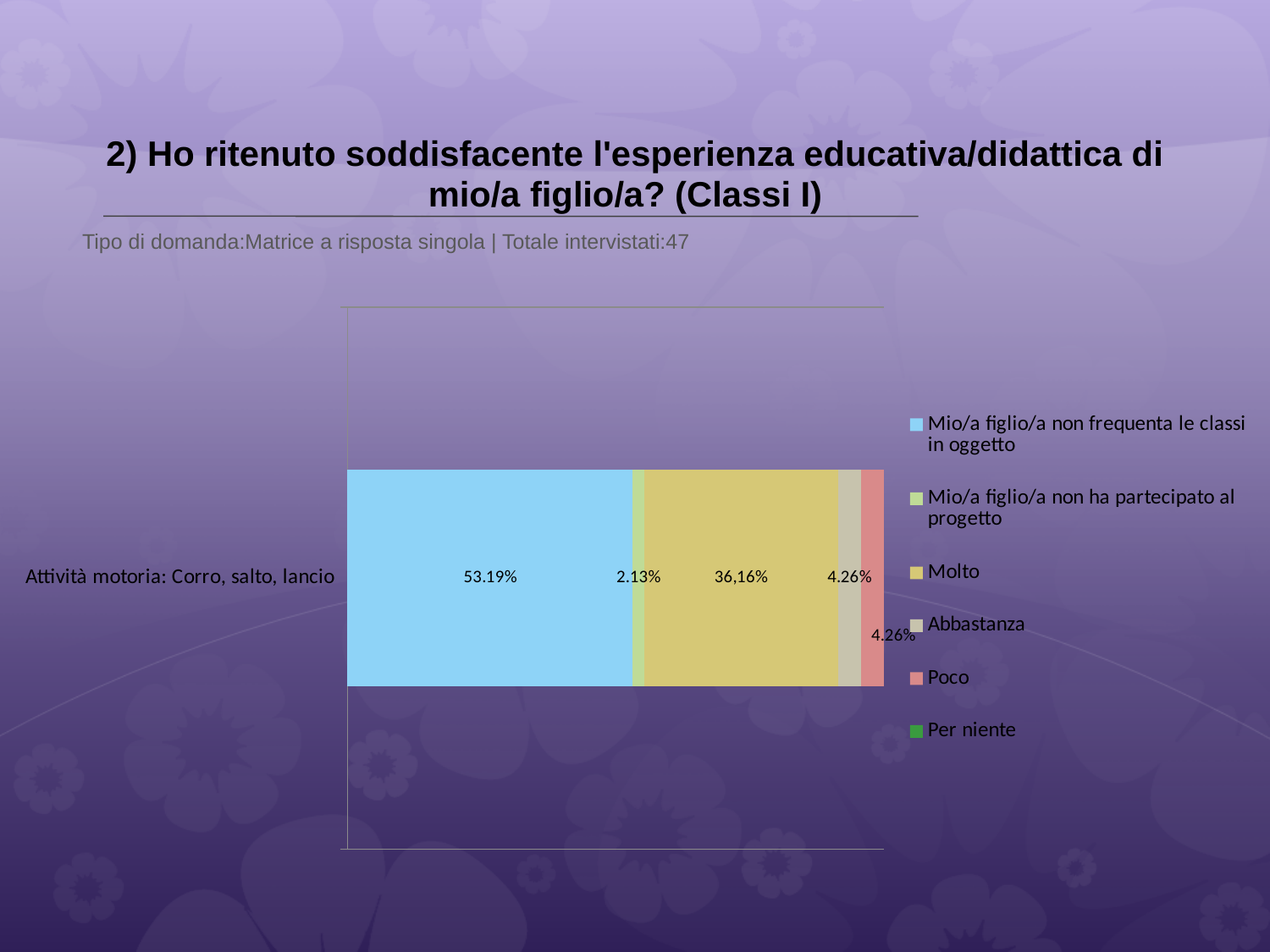
Which series has the smallest printed value in the stacked bar? Mio/a figlio/a non ha partecipato al progetto What is the value for "Poco"? 4.26% Which series has the largest segment in the stacked bar? Mio/a figlio/a non frequenta le classi in oggetto What is the value for "Molto" in the stacked bar? 36,16% What is the value for "Mio/a figlio/a non ha partecipato al progetto"? 2.13% What is the value for "Mio/a figlio/a non frequenta le classi in oggetto" in the stacked bar? 53.19% How many categories are plotted on the chart? 1 Which is larger: the value for "Molto" or the value for "Mio/a figlio/a non frequenta le classi in oggetto"? Mio/a figlio/a non frequenta le classi in oggetto How many series does the legend list? 6 What is the value for "Abbastanza"? 4.26% What kind of chart is shown on the slide? Stacked bar chart What is the difference between the value for "Mio/a figlio/a non frequenta le classi in oggetto" and the value for "Molto"? 17.03%